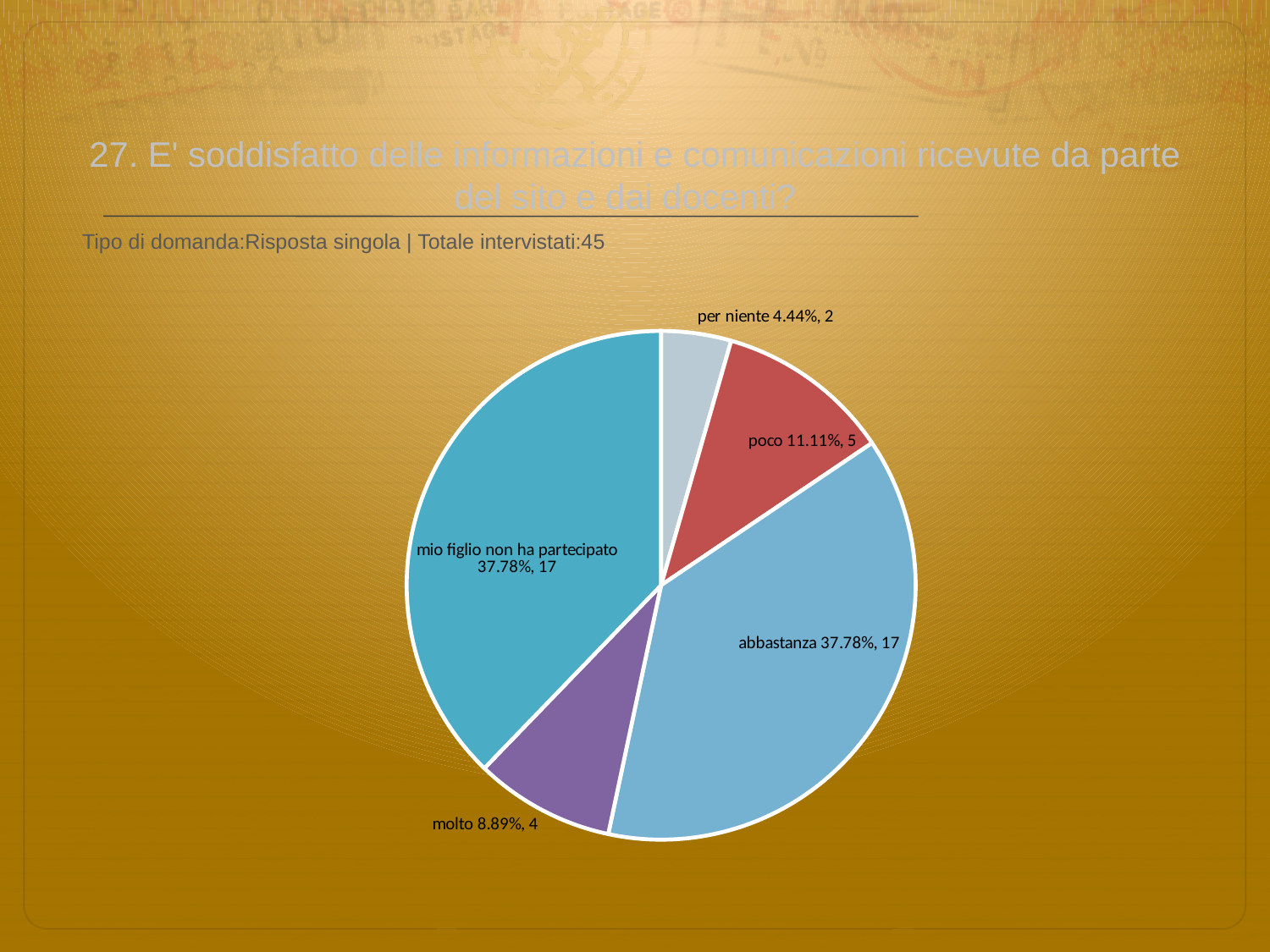
What percentage share does the 'poco' slice have? 11.11% How many slices does the pie chart have? 5 Which has more respondents, 'poco' or 'per niente'? poco What kind of chart is shown on the slide? pie chart What is the difference in respondent count between 'abbastanza' and 'molto'? 13 What percentage share does the 'mio figlio non ha partecipato' slice have? 37.78% How many respondents answered 'per niente'? 2 Which category has the smallest slice of the pie? per niente How many respondents answered 'abbastanza'? 17 What is the difference in respondent count between 'poco' and 'molto'? 1 What percentage share does the 'molto' slice have? 8.89% What is the total number of respondents stated on the slide? 45